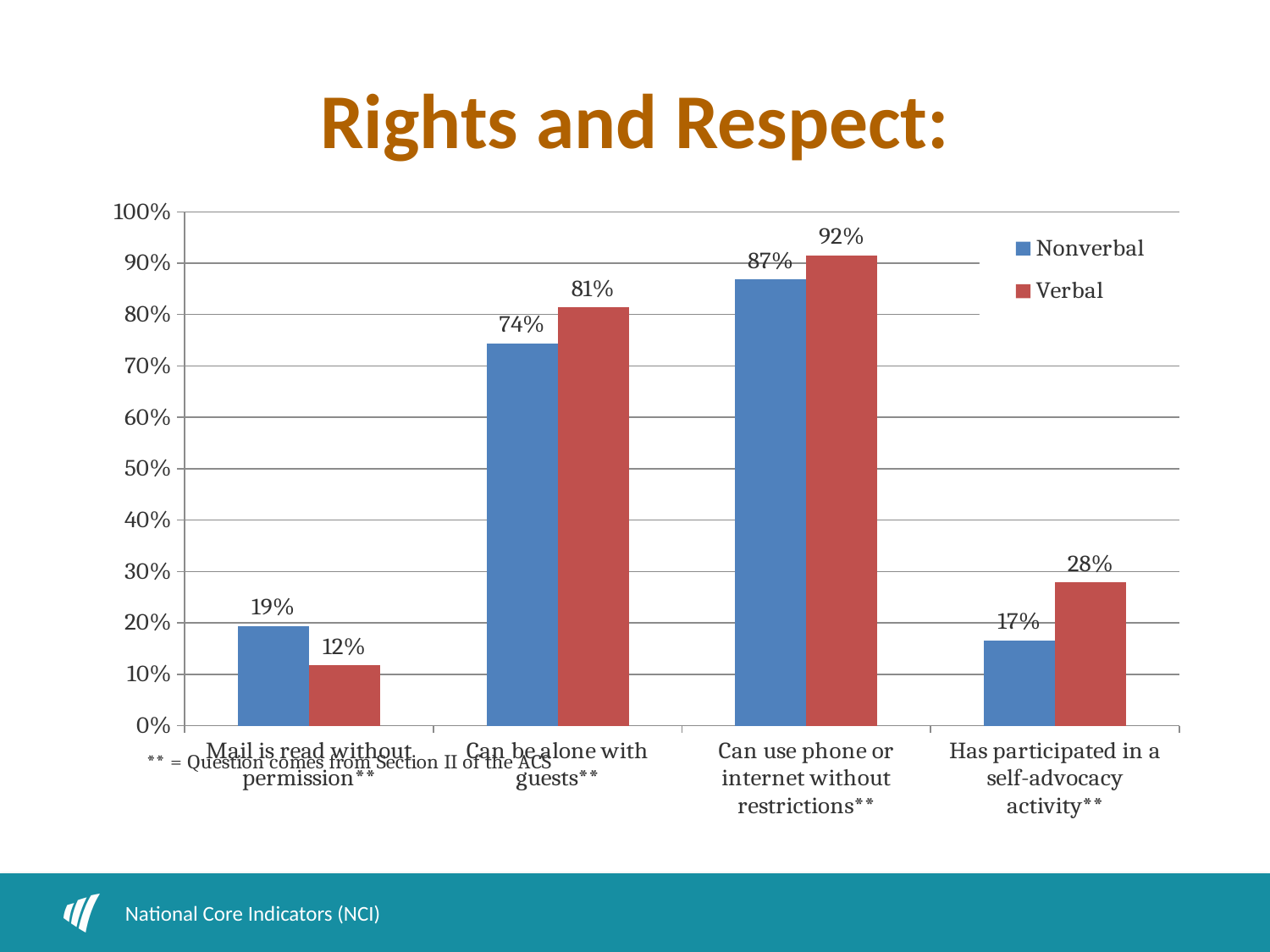
Which category has the lowest Nonverbal value? Has participated in a self-advocacy activity What is the Verbal value for "Can be alone with guests"? 81% What kind of chart is shown on the slide? Bar chart What is the Verbal value for "Has participated in a self-advocacy activity"? 28% What is the difference between the Verbal and Nonverbal values for "Has participated in a self-advocacy activity"? 11% What is the Nonverbal value for "Can use phone or internet without restrictions"? 87% Which category has the highest Verbal value? Can use phone or internet without restrictions How many series does the legend list? 2 What is the Nonverbal value for "Mail is read without permission"? 19% For "Mail is read without permission", which series has the larger value, Nonverbal or Verbal? Nonverbal How many categories are shown on the x axis? 4 Is the Nonverbal value for "Can be alone with guests" greater or less than 70%? greater